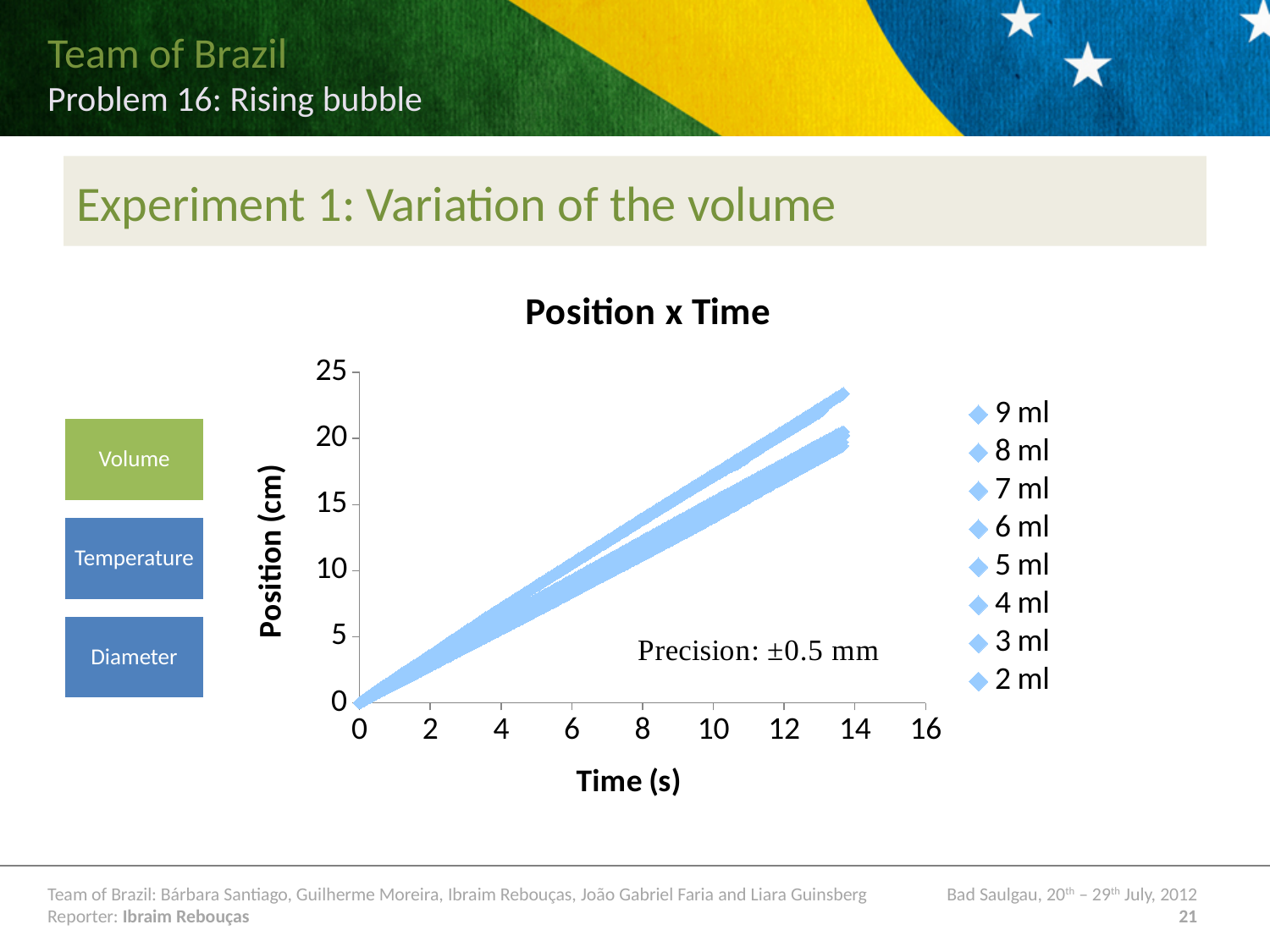
Is the largest time value plotted on the chart greater or less than 12? greater Is the highest position value plotted on the chart greater or less than 25? less What is the maximum value shown on the y axis of the chart? 25 What is the title of the chart? Position x Time Does the position rise or fall as time increases along the x axis? rise Is the largest time value plotted on the chart greater or less than 16? less What is the label of the x axis of the chart? Time (s) How many series does the chart's legend list? 8 What kind of chart is shown on the slide? scatter chart